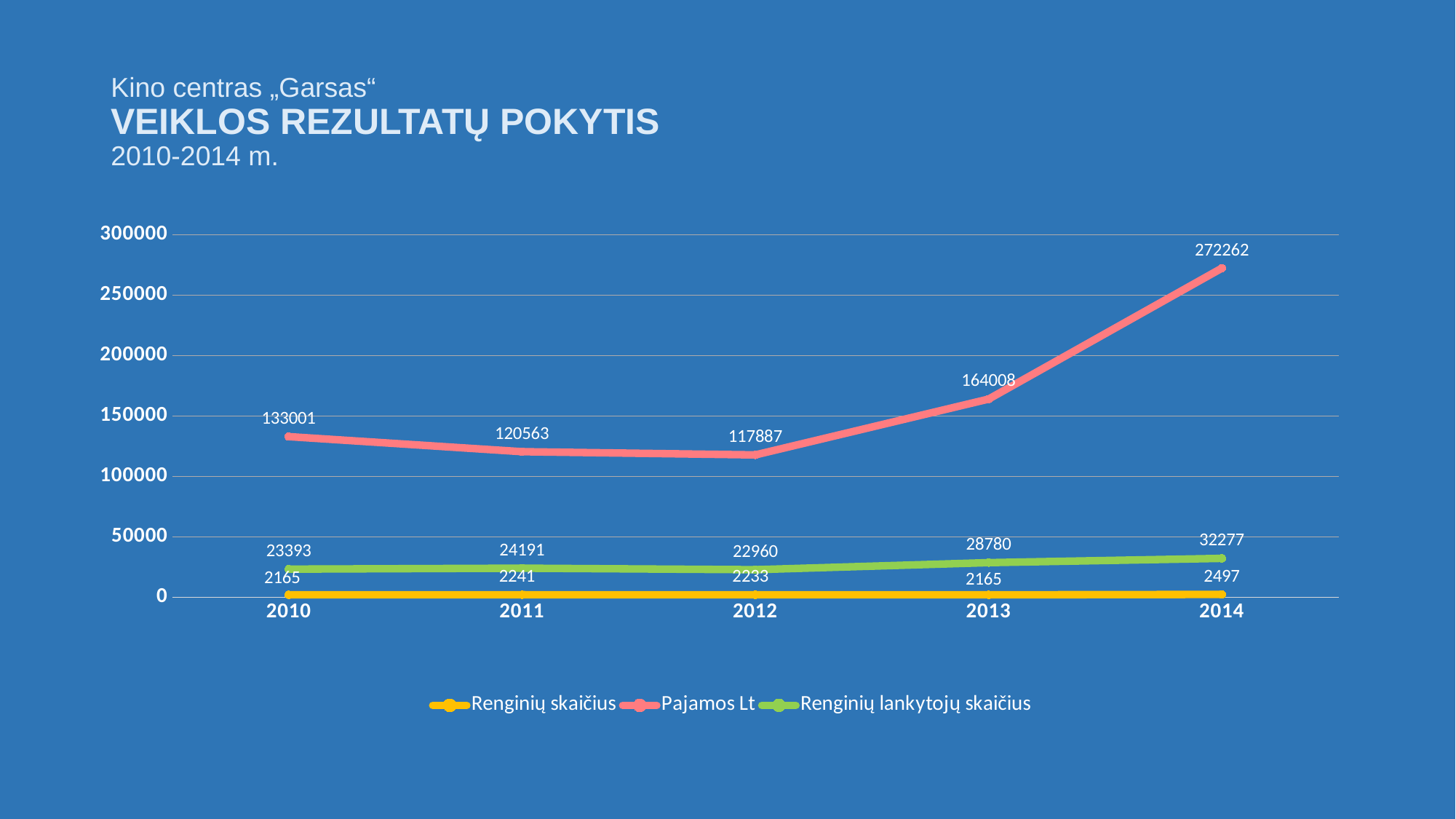
In which year is Renginių lankytojų skaičius highest? 2014 How many years are shown on the x axis? 5 How many series does the legend list? 3 What is the value of Renginių lankytojų skaičius in 2013? 28780 Which is larger, Pajamos Lt in 2010 or in 2011? 2010 What is the difference between Renginių lankytojų skaičius in 2014 and in 2010? 8884 What is the difference between Pajamos Lt in 2014 and in 2013? 108254 In which year is Pajamos Lt lowest? 2012 What is the value of Pajamos Lt in 2014? 272262 What is the value of Renginių skaičius in 2011? 2241 What kind of chart is shown on the slide? line chart Is the value of Pajamos Lt in 2013 greater or less than 150000? greater